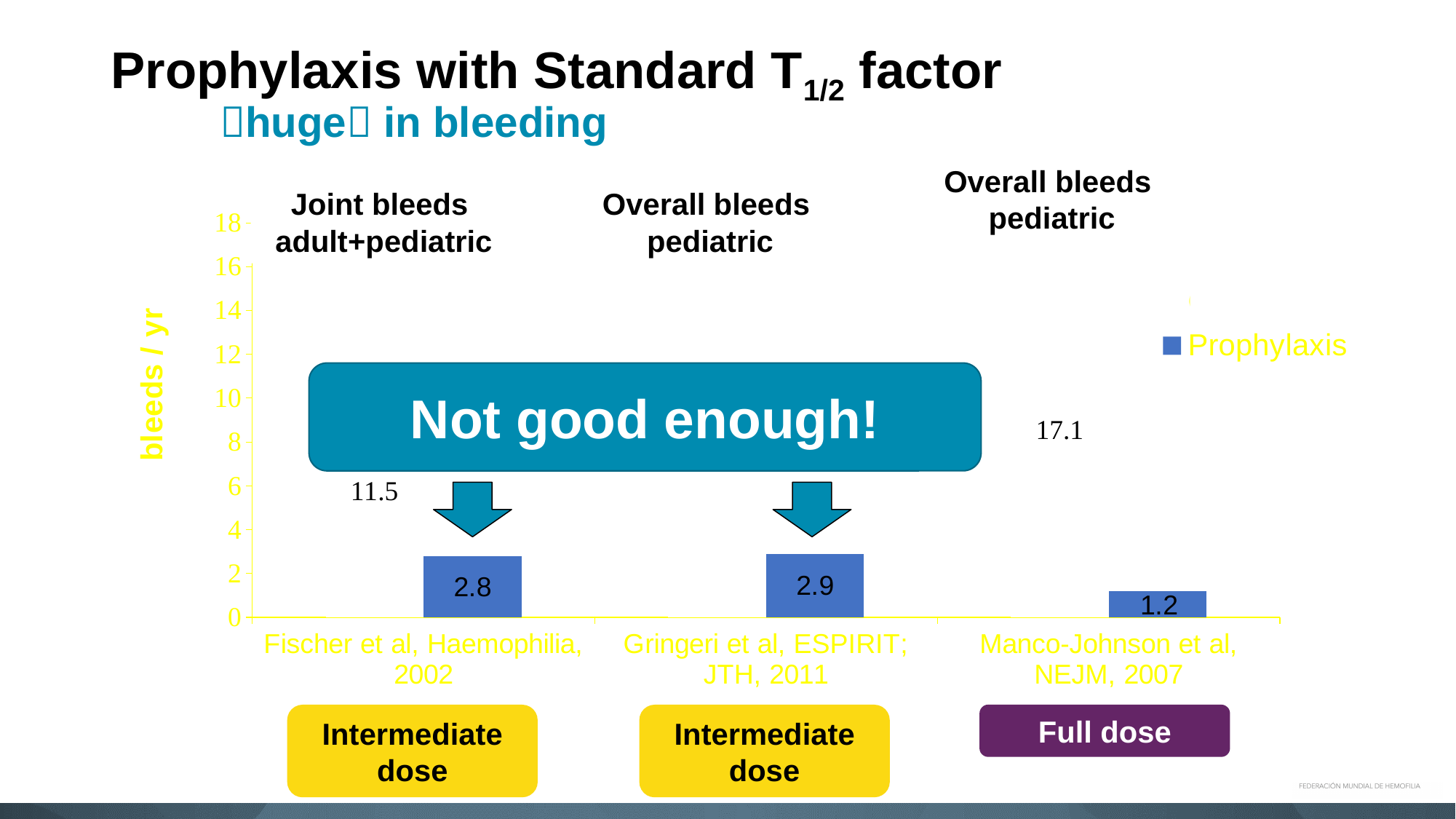
What is the Prophylaxis value for Manco-Johnson et al, NEJM, 2007? 1.2 Which study has the lowest Prophylaxis bleeds per year? Manco-Johnson et al, NEJM, 2007 What kind of chart is shown on the slide? bar chart What is the difference between the Prophylaxis values for Gringeri et al, 2011 and Manco-Johnson et al, 2007? 1.7 How many studies are shown on the x axis of the chart? 3 What is the Prophylaxis value for Gringeri et al, ESPIRIT; JTH, 2011? 2.9 What is the Prophylaxis value for Fischer et al, Haemophilia, 2002? 2.8 What is the difference between the Prophylaxis values for Fischer et al, 2002 and Manco-Johnson et al, 2007? 1.6 Is the Prophylaxis value for Manco-Johnson et al, 2007 greater or less than 2? less Which study has the highest Prophylaxis bleeds per year? Gringeri et al, ESPIRIT; JTH, 2011 What is the label of the y axis? bleeds / yr Which is larger, the Prophylaxis value for Fischer et al, 2002 or for Gringeri et al, 2011? Gringeri et al, 2011